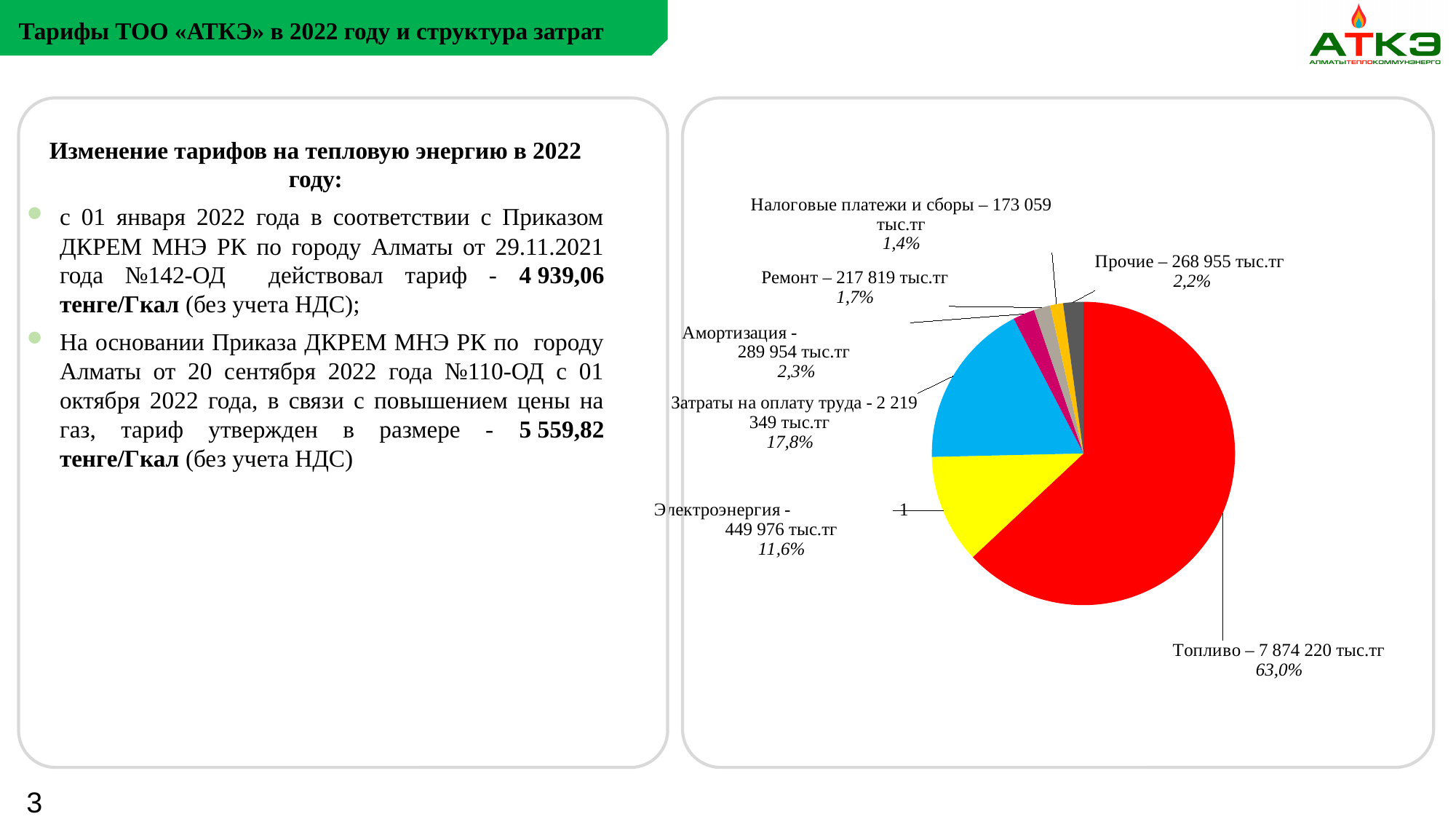
What share of the pie does Амортизация represent? 2,3% What is the difference between the values for Топливо and Затраты на оплату труда? 5 654 871 тыс.тг What colour is the Топливо slice in the pie chart? red What share of the pie does Электроэнергия represent? 11,6% Which category has the smallest share in the pie chart? Налоговые платежи и сборы How many slices does the pie chart have? 7 What is the value for Ремонт in the pie chart? 217 819 тыс.тг Which category has the largest share in the pie chart? Топливо What is the value for Топливо in the pie chart? 7 874 220 тыс.тг What is the value for Затраты на оплату труда in the pie chart? 2 219 349 тыс.тг Which is larger in the pie chart: Затраты на оплату труда or Электроэнергия? Затраты на оплату труда What kind of chart is shown on the right side of the slide? pie chart